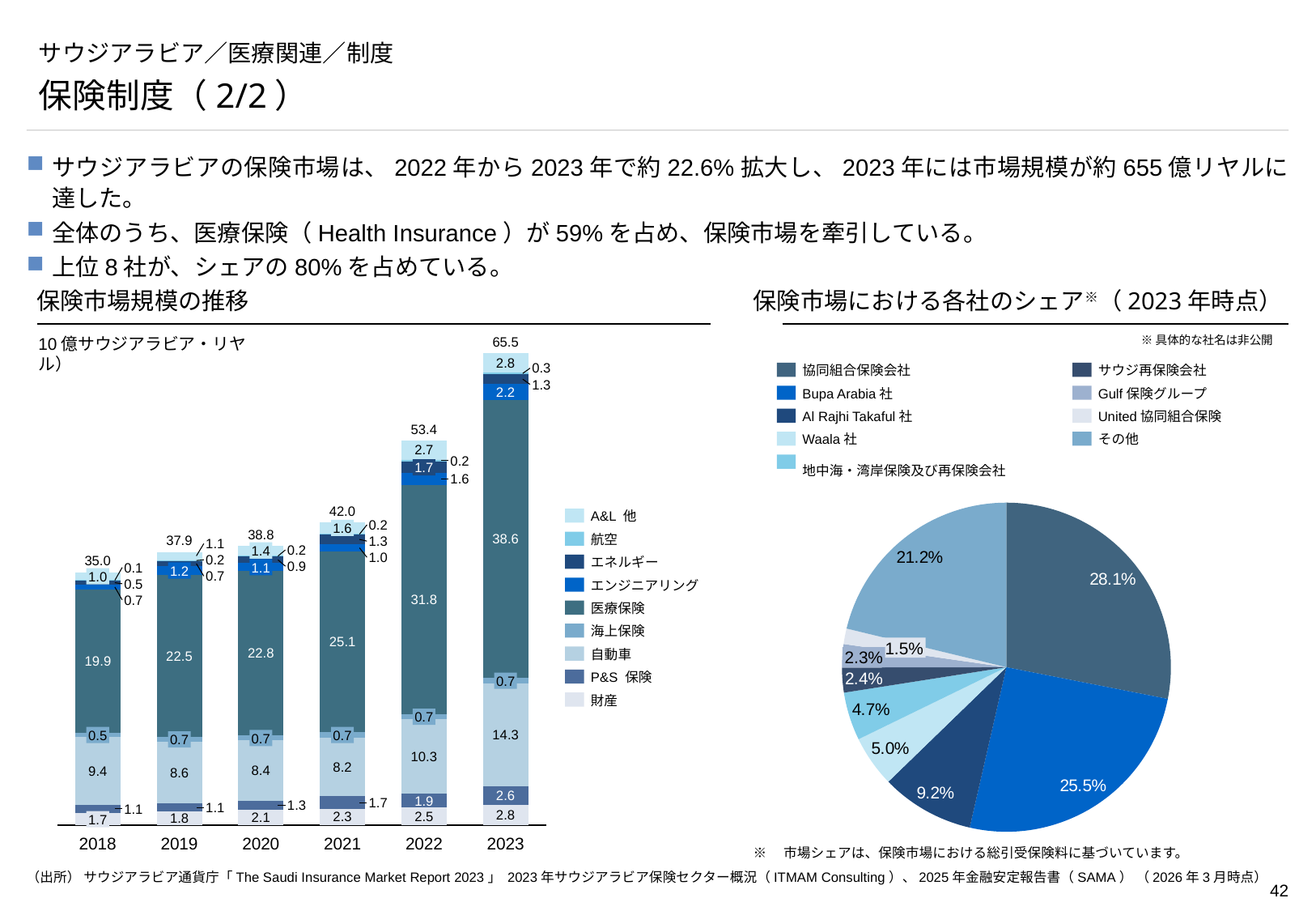
In the 保険市場規模の推移 chart, which year has the lowest total market size? 2018 What kind of chart is the 保険市場規模の推移 chart? stacked bar chart In the 保険市場規模の推移 chart, what is the value of 自動車 in 2023? 14.3 In the 保険市場規模の推移 chart, how many series does the legend list? 9 In the 保険市場における各社のシェア pie chart, which company has the largest share? 協同組合保険会社 In the 保険市場規模の推移 chart, what is the value of 医療保険 in 2022? 31.8 In the 保険市場規模の推移 chart, what is the total market size for 2023? 65.5 In the 保険市場における各社のシェア pie chart, what share is labelled その他? 21.2% In the 保険市場における各社のシェア pie chart, what share does Bupa Arabia 社 hold? 25.5% In the 保険市場規模の推移 chart, what is the difference between the total for 2023 and the total for 2022? 12.1 In the 保険市場における各社のシェア pie chart, which is larger: the share of Al Rajhi Takaful 社 or the share of Waala 社? Al Rajhi Takaful 社 In the 保険市場規模の推移 chart, do the total values rise or fall from 2018 to 2023? rise